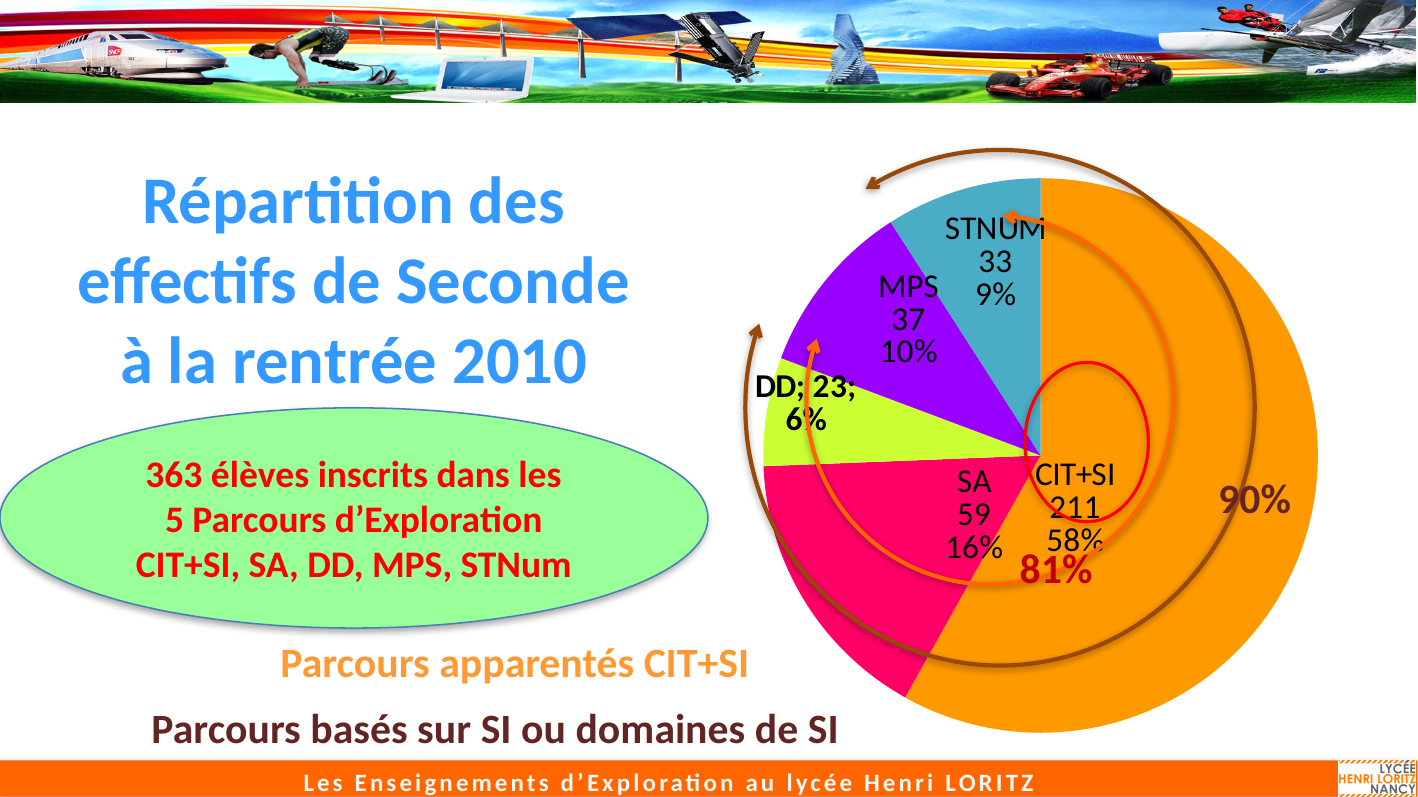
Which category has the largest slice of the pie? CIT+SI Which category has the smallest slice of the pie? DD Which is larger, the value for MPS or the value for STNUM? MPS How many slices does the pie chart have? 5 What share of the pie does STNUM represent? 9% What is the value for DD in the pie chart? 23 What is the difference between the values for SA and MPS? 22 What is the value for MPS in the pie chart? 37 What is the value for CIT+SI in the pie chart? 211 What is the title of the slide above the pie chart? Répartition des effectifs de Seconde à la rentrée 2010 What share of the pie does SA represent? 16% What kind of chart is shown on the slide? pie chart